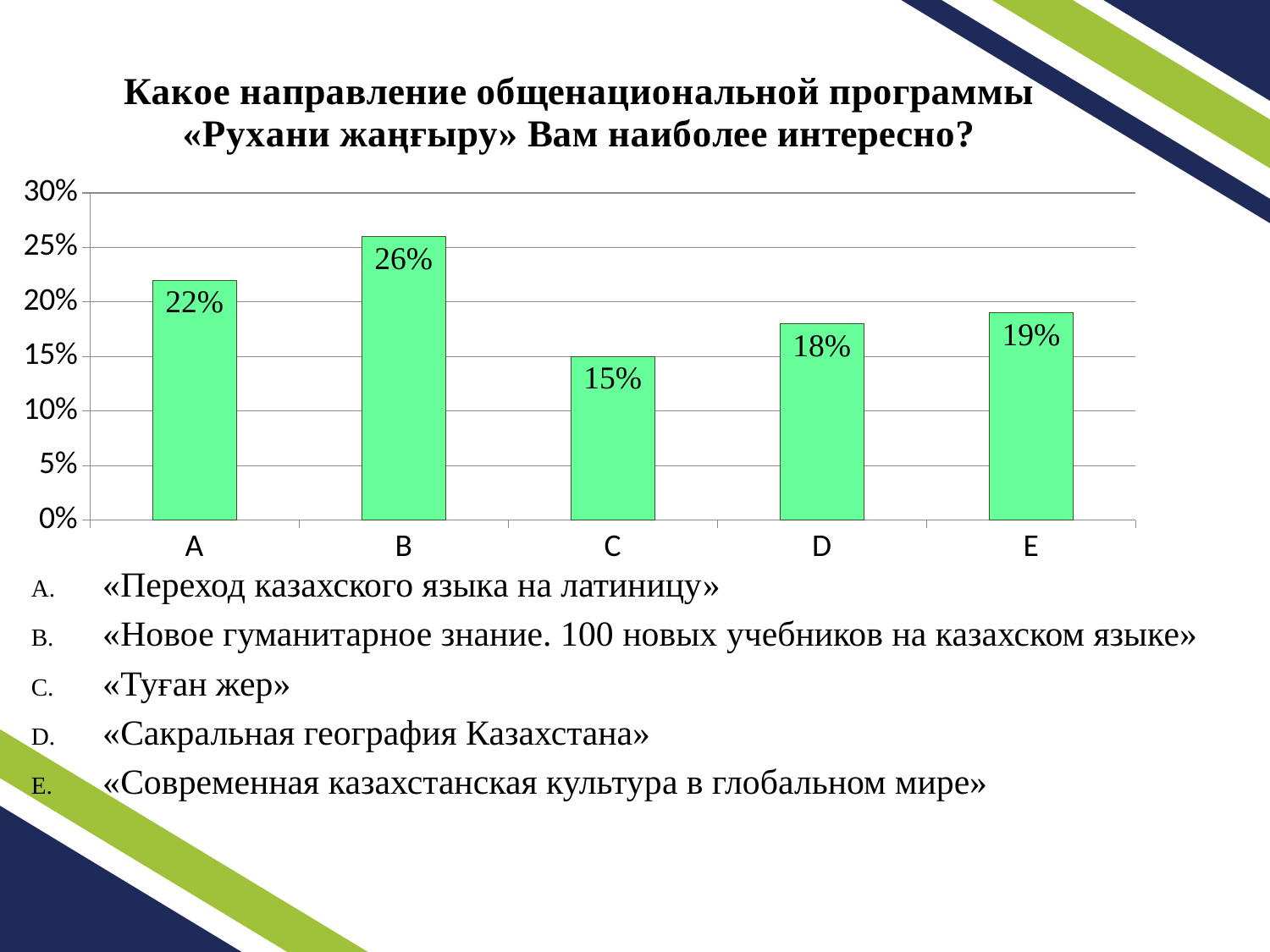
What is the difference between the values for B and A? 4% Which category has the lowest value? C Is the value for D greater or less than 20%? less What is the maximum value shown on the vertical axis? 30% What is the value for category C? 15% What is the difference between the values for E and C? 4% What is the value for category B? 26% What kind of chart is shown on the slide? bar chart How many categories are shown on the x axis? 5 Which category has the highest value? B Which is larger, the value for A or the value for D? A What is the value for category E? 19%